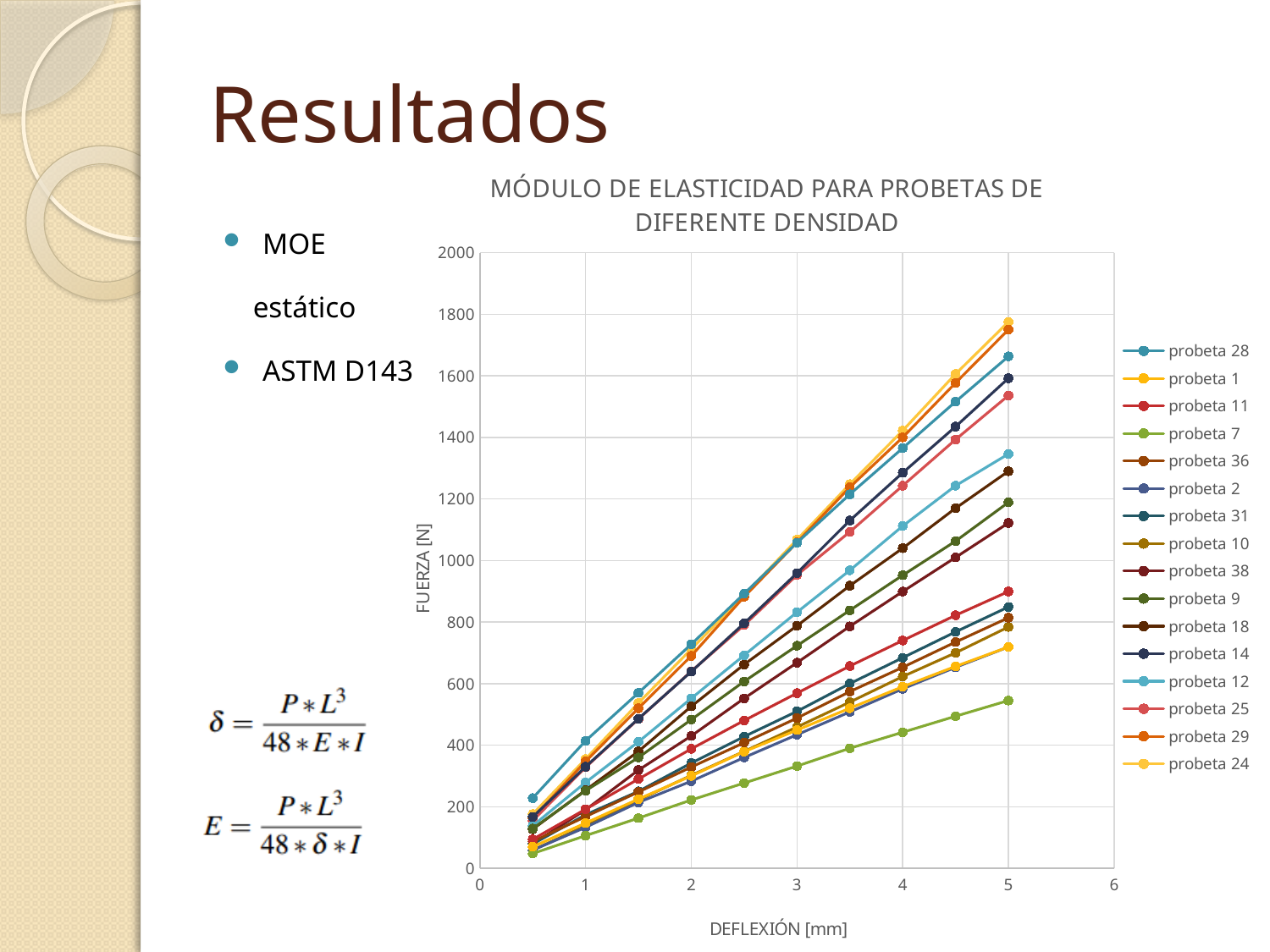
Which series has the lowest value at a deflection of 5 mm? probeta 7 Do the values for probeta 28 rise or fall as deflection increases along the x axis? rise What kind of chart is shown on the slide? line chart Is the value for probeta 7 at a deflection of 5 mm greater or less than 600? less At a deflection of 5 mm, which is larger: the value for probeta 28 or the value for probeta 7? probeta 28 What is the label of the vertical axis of the chart? FUERZA [N] How many data points are plotted for each series in the chart? 10 Is the value for probeta 12 at a deflection of 5 mm greater or less than 1400? less What is the title of the chart? MÓDULO DE ELASTICIDAD PARA PROBETAS DE DIFERENTE DENSIDAD Is the value for probeta 28 at a deflection of 5 mm greater or less than 1400? greater How many series does the legend of the chart list? 16